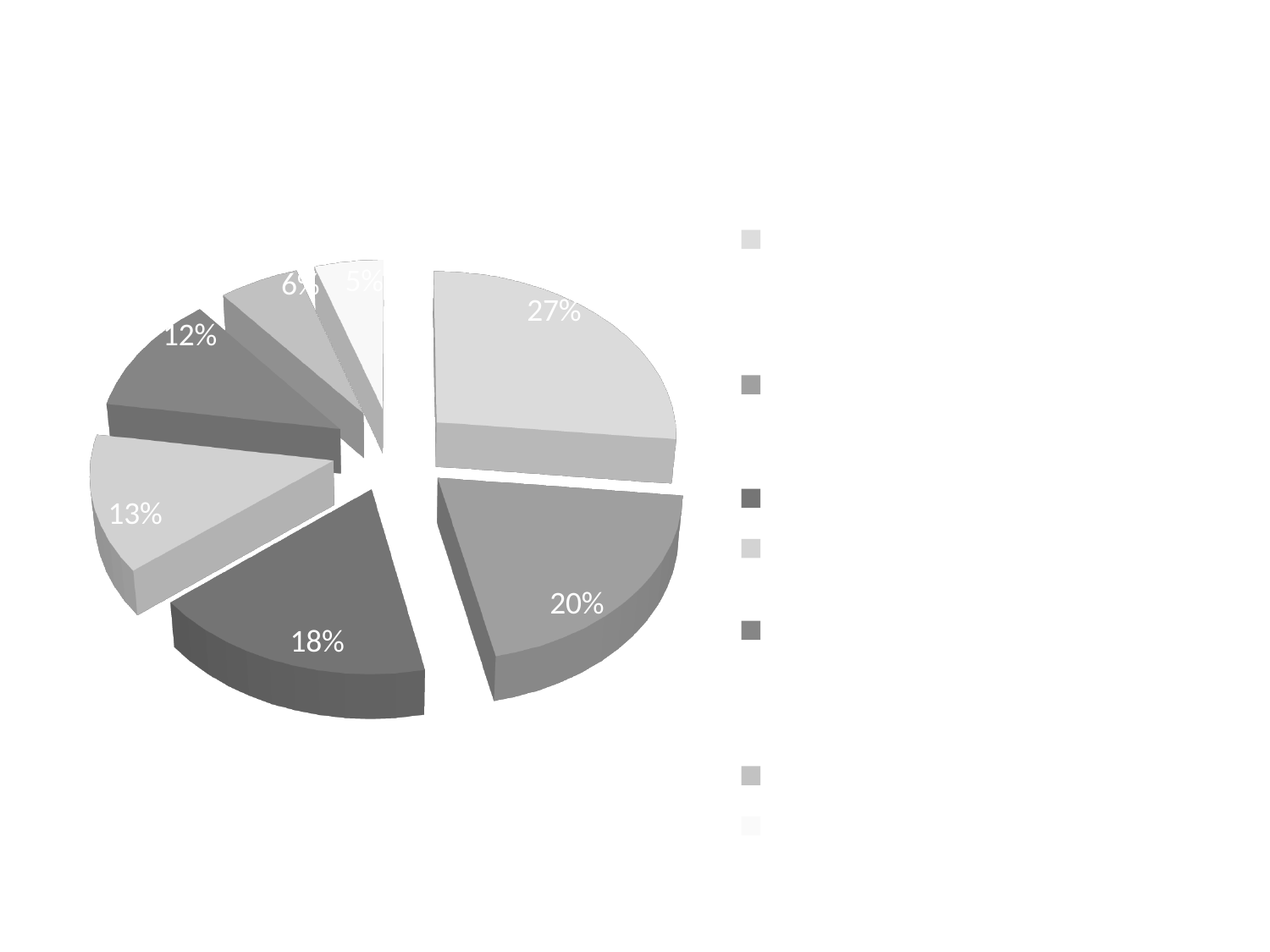
What is the largest percentage shown on the pie chart? 27% How many entries does the legend list? 7 Which is larger, the slice labeled 13% or the slice labeled 12%? 13% What is the difference in percentage points between the largest slice (27%) and the smallest slice (5%)? 22 What kind of chart is shown on the slide? pie chart What is the difference in percentage points between the 20% slice and the 18% slice? 2 What is the second-largest percentage shown on the pie chart? 20% What is the smallest percentage shown on the pie chart? 5% How many slices does the pie chart have? 7 Are the slices of the pie chart separated (exploded) from each other? yes